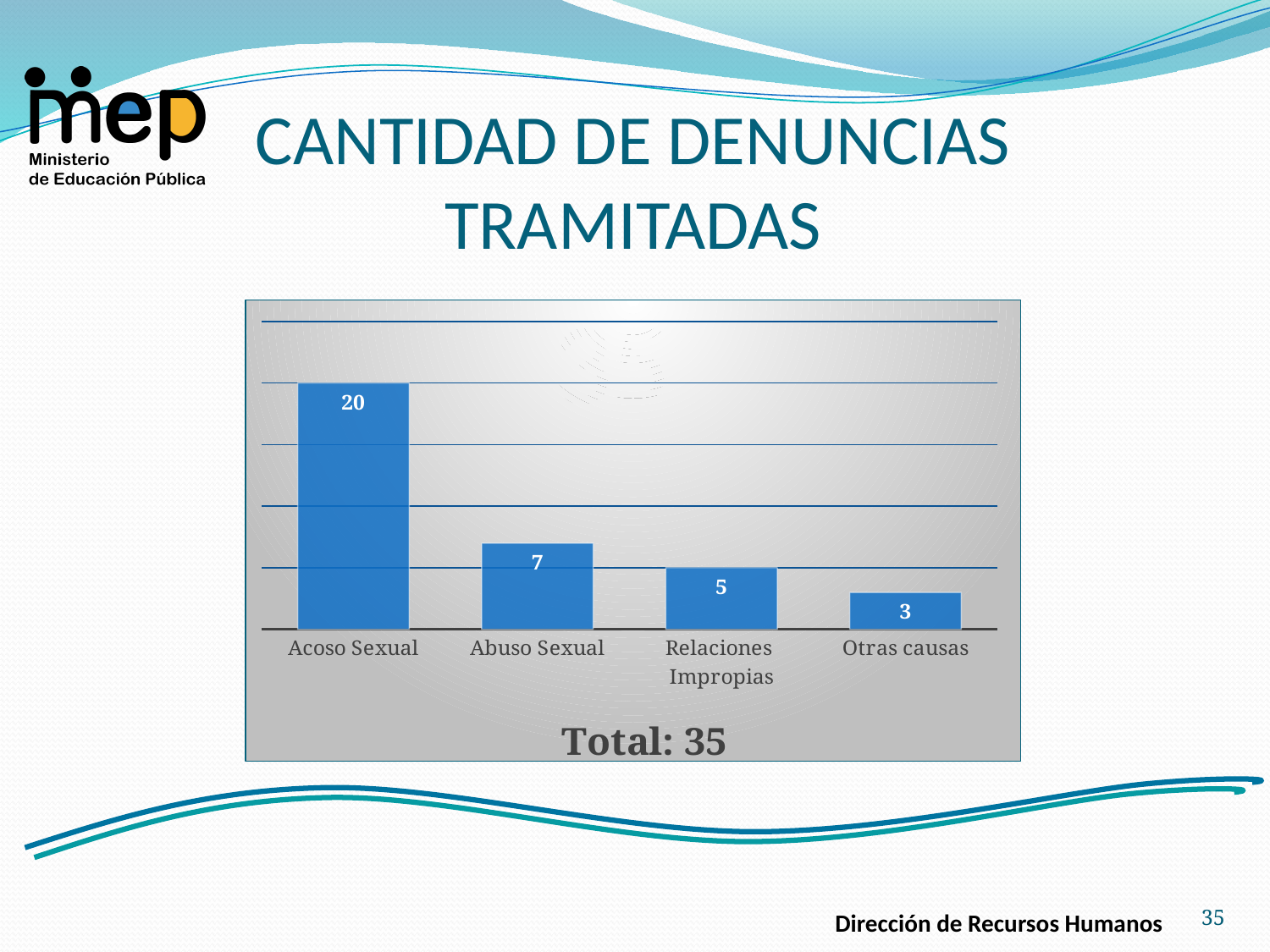
What total is printed below the chart? Total: 35 Which category has the highest value? Acoso Sexual What is the value for Acoso Sexual? 20 What kind of chart is shown on the slide? bar chart What is the value for Relaciones Impropias? 5 What is the difference between the values for Acoso Sexual and Abuso Sexual? 13 What is the difference between the values for Relaciones Impropias and Otras causas? 2 What is the value for Abuso Sexual? 7 How many categories are shown in the chart? 4 What is the value for Otras causas? 3 Which is larger, the value for Abuso Sexual or the value for Relaciones Impropias? Abuso Sexual Which category has the lowest value? Otras causas